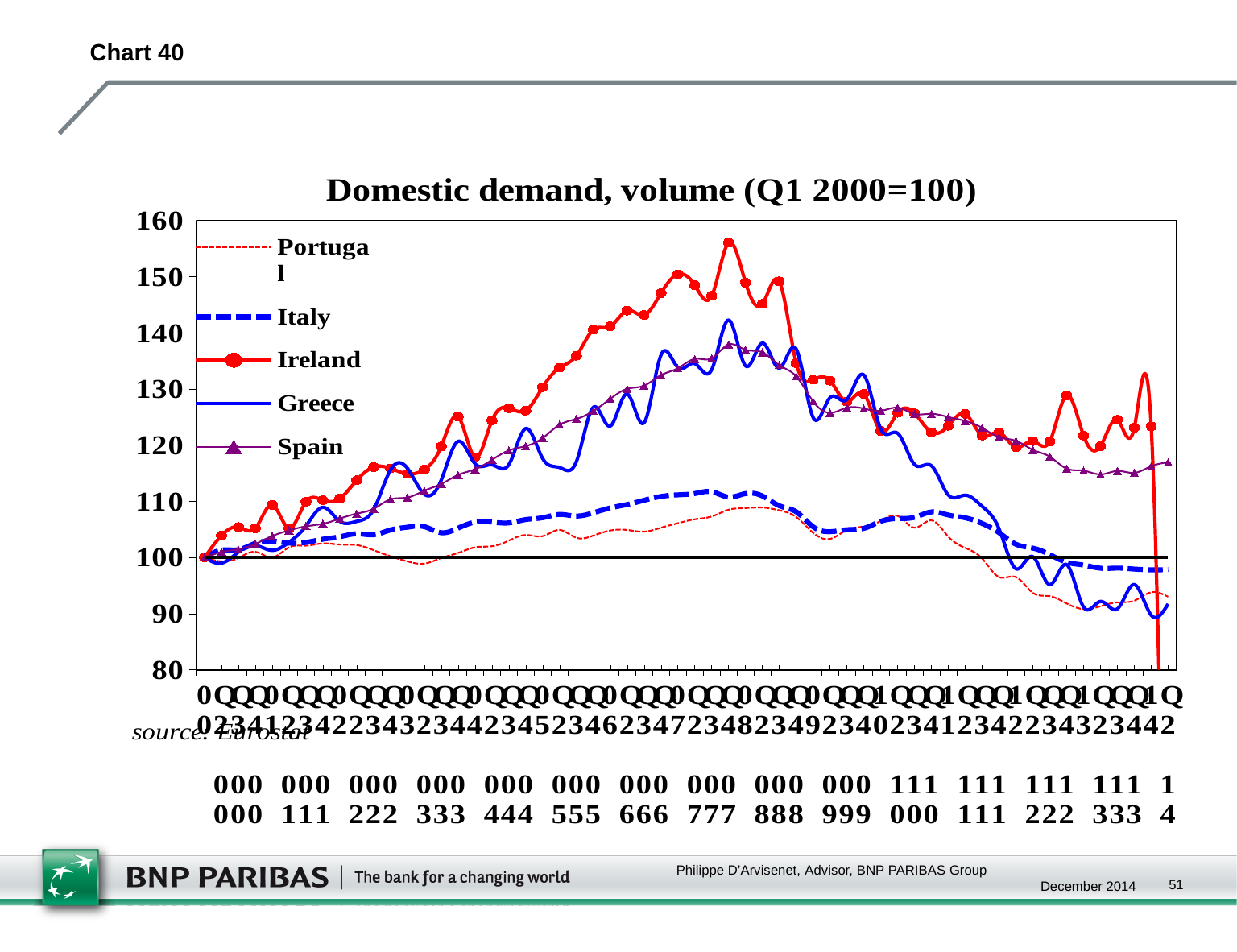
Is the peak value for Ireland greater or less than 150? greater How many series does the legend list? 5 Which series reaches the highest value on the chart? Ireland At their respective peaks, which series is higher, Spain or Italy? Spain Is the peak value for Spain greater or less than 130? greater What is the title of the chart? Domestic demand, volume (Q1 2000=100) What kind of chart is shown on the slide? line chart Does the Greece series rise or fall between 2008 and 2014? fall Is the value for Greece at the end of the series (2014) greater or less than 100? less Which countries are listed in the chart's legend? Portugal, Italy, Ireland, Greece, Spain